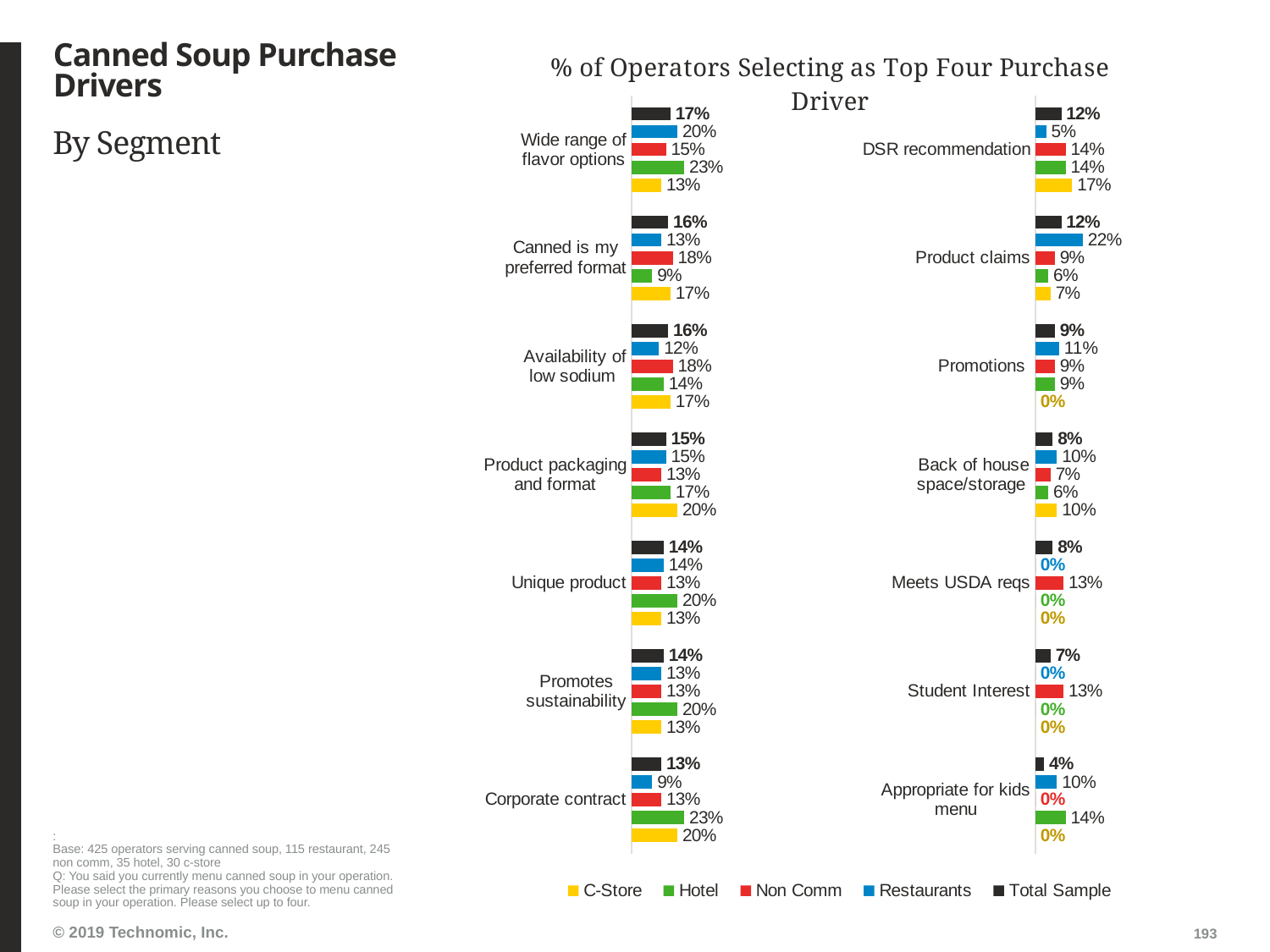
In the right chart, which category has the lowest Total Sample value? Appropriate for kids menu How many series does the legend list? 5 Which colour represents Non Comm in the legend? Red In the right chart, what is the C-Store value for DSR recommendation? 17% In the right chart, which is larger for Product claims: the Restaurants value or the Non Comm value? Restaurants In the left chart, which category has the highest Total Sample value? Wide range of flavor options In the left chart, what is the Total Sample value for Wide range of flavor options? 17% In the left chart, what is the difference between the Hotel and C-Store values for Wide range of flavor options? 10% In the left chart, what is the Hotel value for Corporate contract? 23% In the right chart, what is the Restaurants value for Product claims? 22% What kind of chart is used on this slide? Bar chart How many categories are shown in the left chart? 7